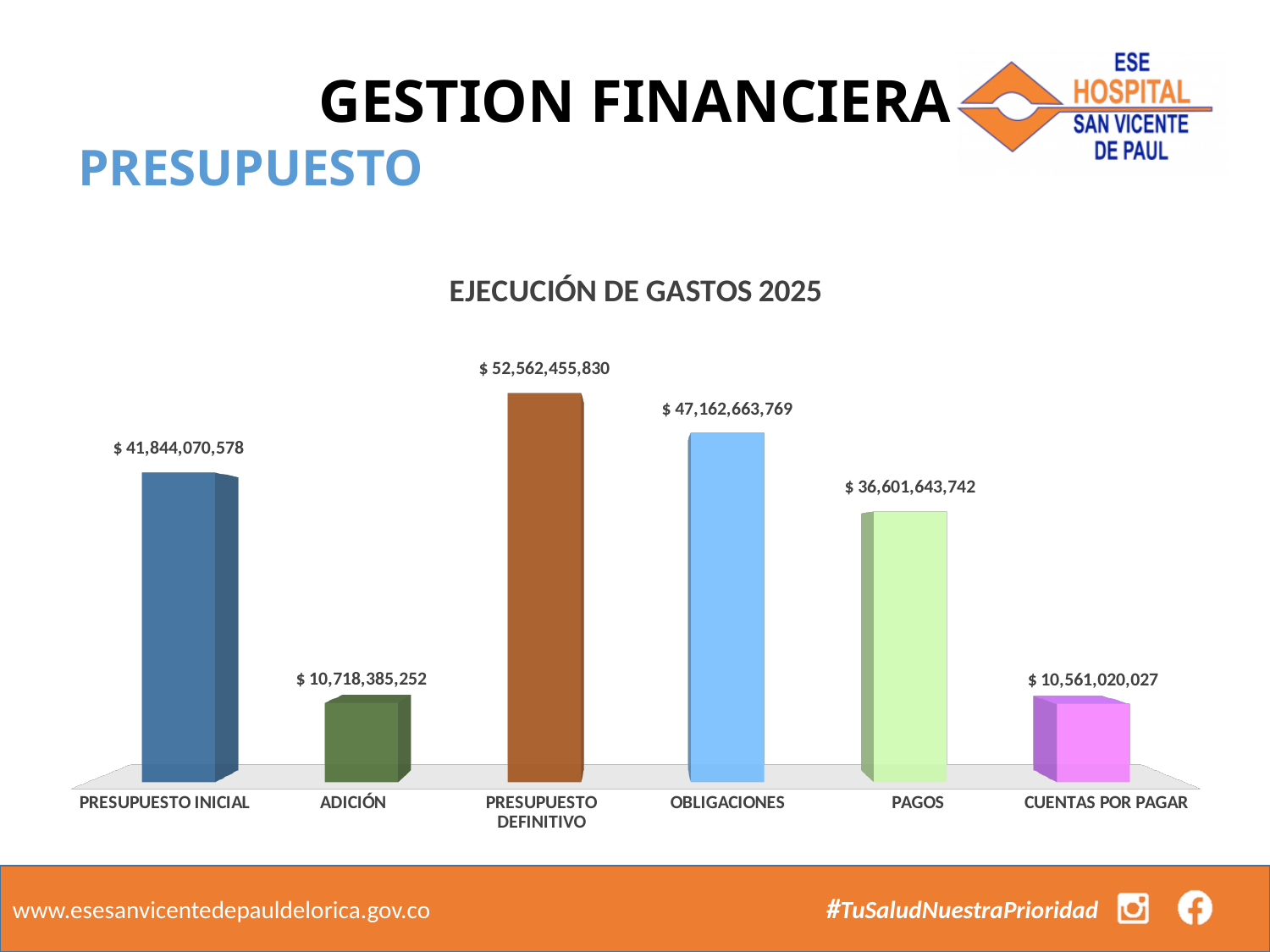
What is the difference between OBLIGACIONES and PAGOS in the EJECUCIÓN DE GASTOS 2025 chart? $ 10,561,020,027 Which category has the lowest value in the EJECUCIÓN DE GASTOS 2025 chart? CUENTAS POR PAGAR How many categories are shown in the EJECUCIÓN DE GASTOS 2025 chart? 6 What kind of chart is the EJECUCIÓN DE GASTOS 2025 chart? Bar chart Which is larger in the EJECUCIÓN DE GASTOS 2025 chart, PRESUPUESTO INICIAL or OBLIGACIONES? OBLIGACIONES What is the title of the chart on the slide? EJECUCIÓN DE GASTOS 2025 What is the value for ADICIÓN in the EJECUCIÓN DE GASTOS 2025 chart? $ 10,718,385,252 What is the value for CUENTAS POR PAGAR in the EJECUCIÓN DE GASTOS 2025 chart? $ 10,561,020,027 What is the value for PRESUPUESTO DEFINITIVO in the EJECUCIÓN DE GASTOS 2025 chart? $ 52,562,455,830 What is the value for PAGOS in the EJECUCIÓN DE GASTOS 2025 chart? $ 36,601,643,742 Which category has the highest value in the EJECUCIÓN DE GASTOS 2025 chart? PRESUPUESTO DEFINITIVO What is the difference between PRESUPUESTO DEFINITIVO and OBLIGACIONES in the EJECUCIÓN DE GASTOS 2025 chart? $ 5,399,792,061